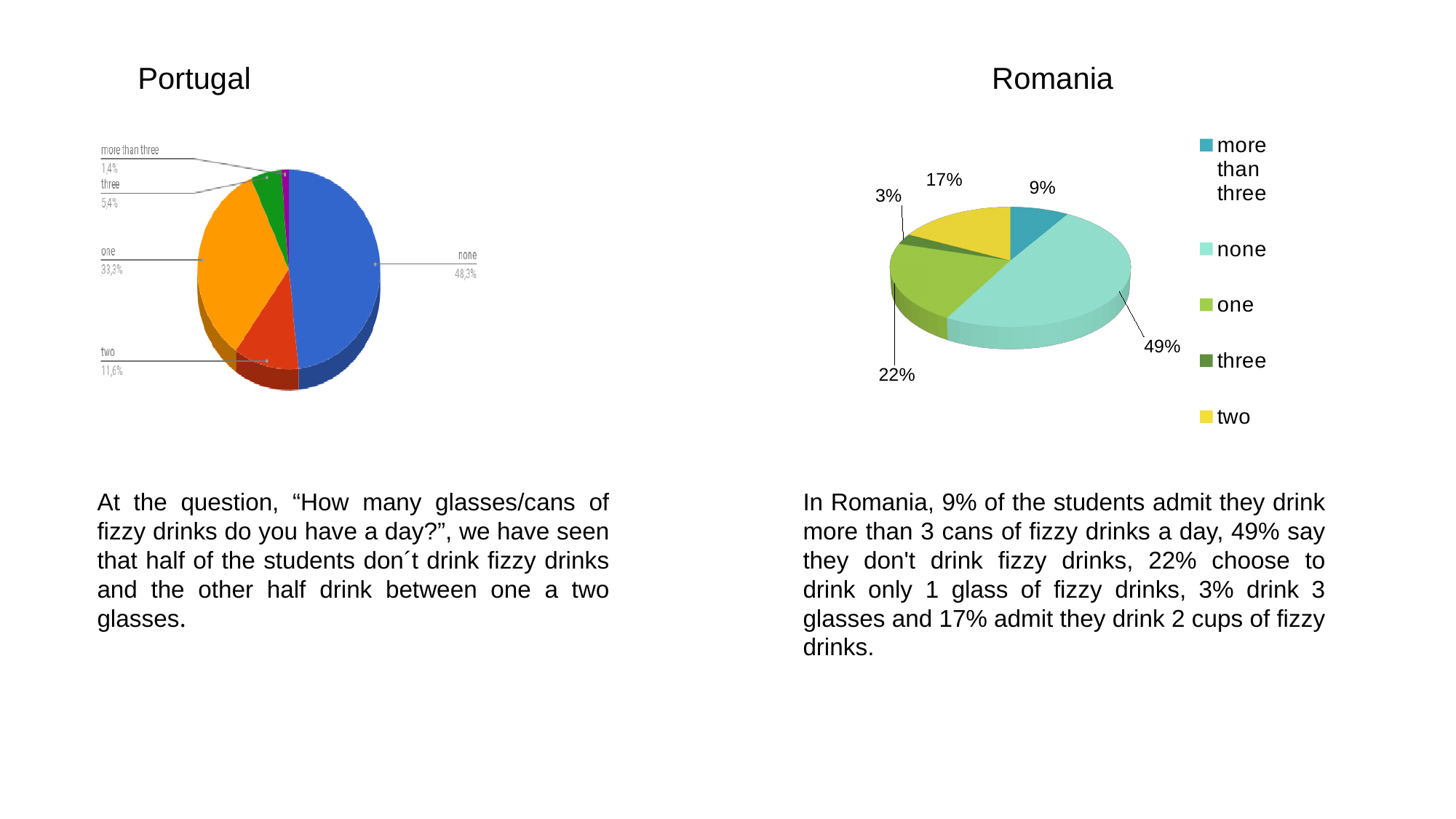
On the Portugal chart, what percentage of students answered "two"? 11,6% How many categories does the legend of the Romania chart list? 5 On the Romania chart, which category has the largest share? none On the Romania chart, what percentage of students answered "none"? 49% On the Portugal chart, what is the difference between the "none" and "one" shares? 15 percentage points On the Romania chart, what is the difference between the "one" and "two" shares? 5 percentage points What type of chart is the Romania chart? Pie chart On the Romania chart, what percentage of students answered "three"? 3% On the Portugal chart, what percentage of students answered "one"? 33,3% On the Portugal chart, what percentage of students answered "none"? 48,3% On the Romania chart, which is larger, the share for "two" or the share for "more than three"? two On the Portugal chart, which category has the smallest share? more than three